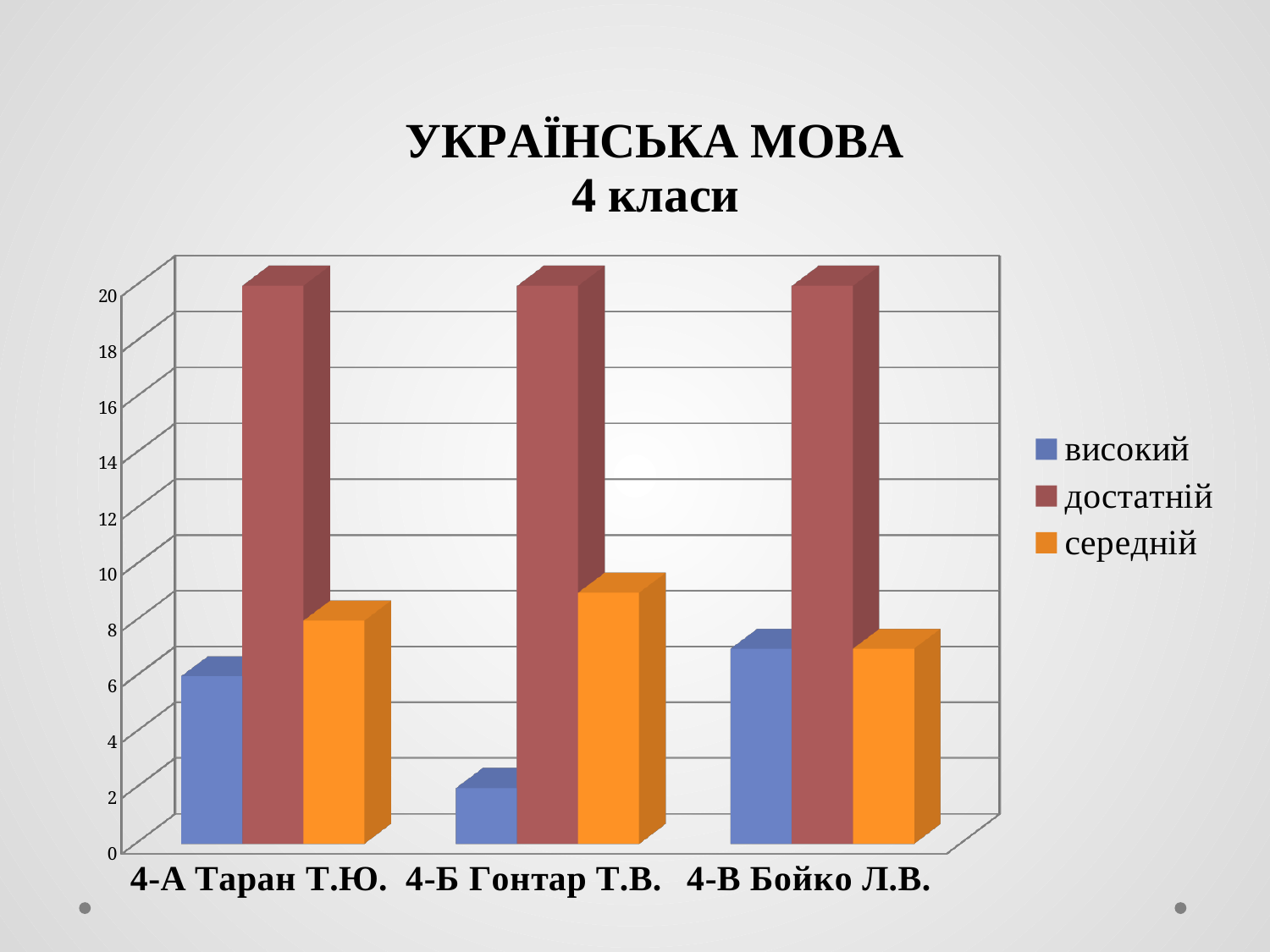
Which class has the larger value for високий: 4-А Таран Т.Ю. or 4-Б Гонтар Т.В.? 4-А Таран Т.Ю. Is the value for середній in 4-Б Гонтар Т.В. greater or less than 6? greater Is the value for високий in 4-Б Гонтар Т.В. greater or less than 4? less What kind of chart is shown on the slide? bar chart Is the value for високий in 4-В Бойко Л.В. greater or less than 4? greater How many series does the legend list? 3 Which class has the lowest value for високий? 4-Б Гонтар Т.В. What is the title of the chart? УКРАЇНСЬКА МОВА 4 класи How many classes (categories) are shown on the x axis? 3 Which is larger for 4-А Таран Т.Ю.: високий or достатній? достатній Which series is shown in orange in the legend? середній